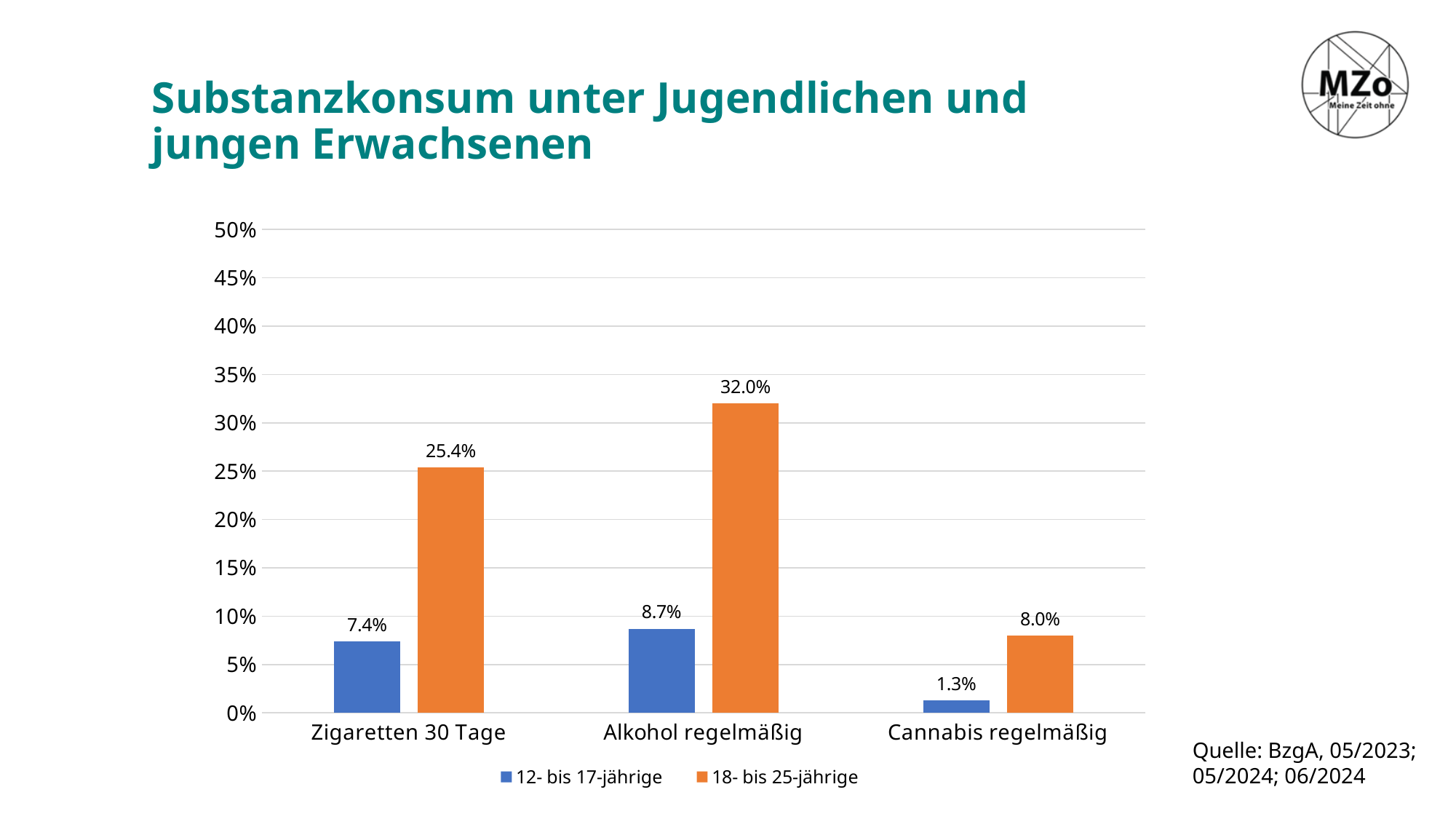
What is the difference between the 18- bis 25-jährige and 12- bis 17-jährige values for Zigaretten 30 Tage? 18.0% What is the value for 12- bis 17-jährige for Zigaretten 30 Tage? 7.4% Which category has the lowest value for 12- bis 17-jährige? Cannabis regelmäßig What is the value for 18- bis 25-jährige for Alkohol regelmäßig? 32.0% How many categories are shown on the x axis? 3 How many series does the legend list? 2 Which is larger for Cannabis regelmäßig: the value for 12- bis 17-jährige or for 18- bis 25-jährige? 18- bis 25-jährige What is the value for 12- bis 17-jährige for Cannabis regelmäßig? 1.3% Which category has the highest value for 18- bis 25-jährige? Alkohol regelmäßig What colour are the bars for 18- bis 25-jährige? Orange What kind of chart is shown on the slide? Bar chart Is the value for 18- bis 25-jährige for Zigaretten 30 Tage greater or less than 20%? greater